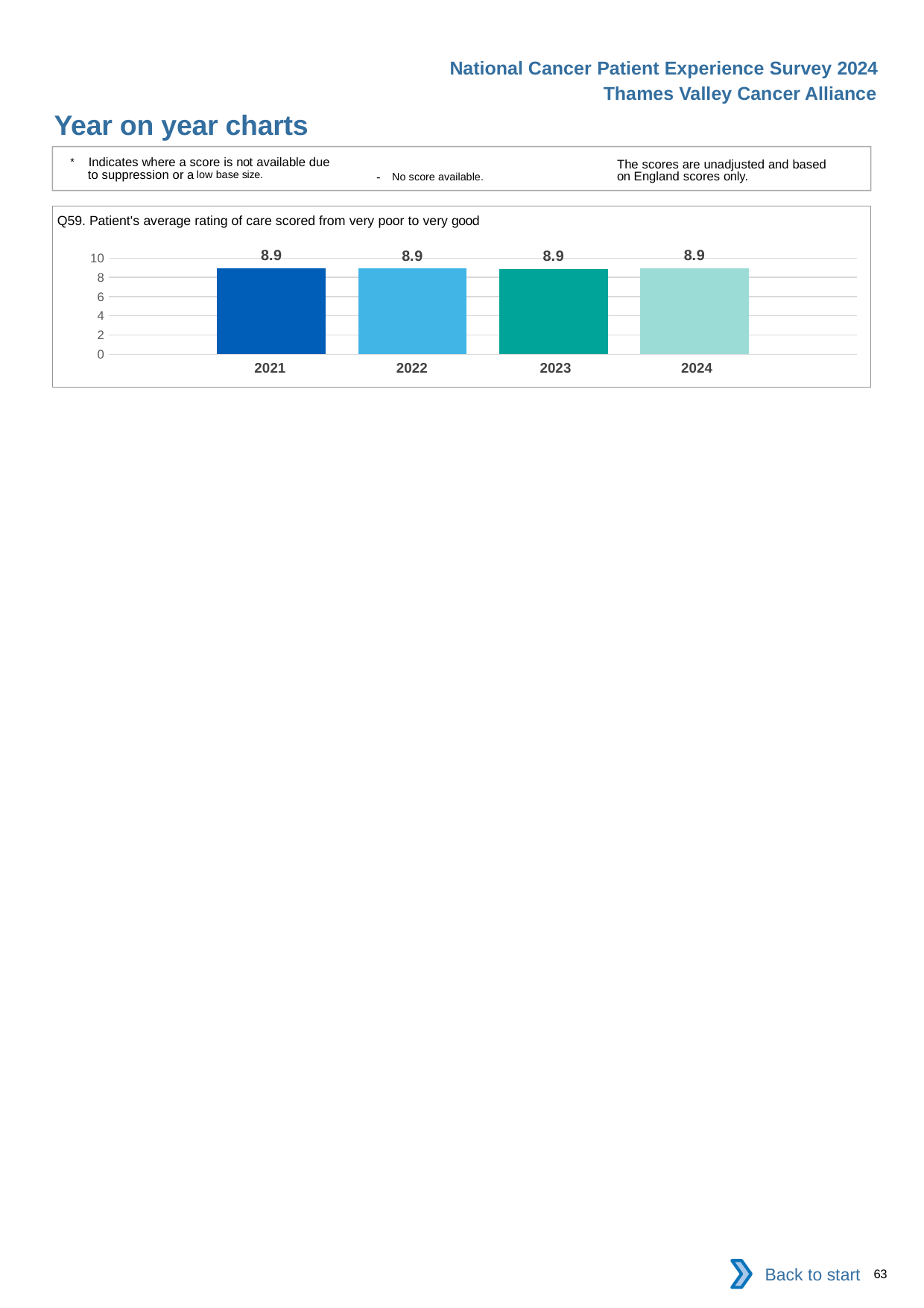
Do the values rise, fall or stay the same from 2021 to 2024? stay the same Is the value for 2022 greater or less than 10? less What is the value for 2024? 8.9 What is the value for 2021? 8.9 Is the value for 2023 greater or less than 8? greater What is the value for 2022? 8.9 What is the highest value shown on the vertical axis? 10 How many years are shown on the chart? 4 What is the value for 2023? 8.9 What is the difference between the values for 2021 and 2024? 0 What is the title of the chart? Q59. Patient's average rating of care scored from very poor to very good What kind of chart is shown? bar chart